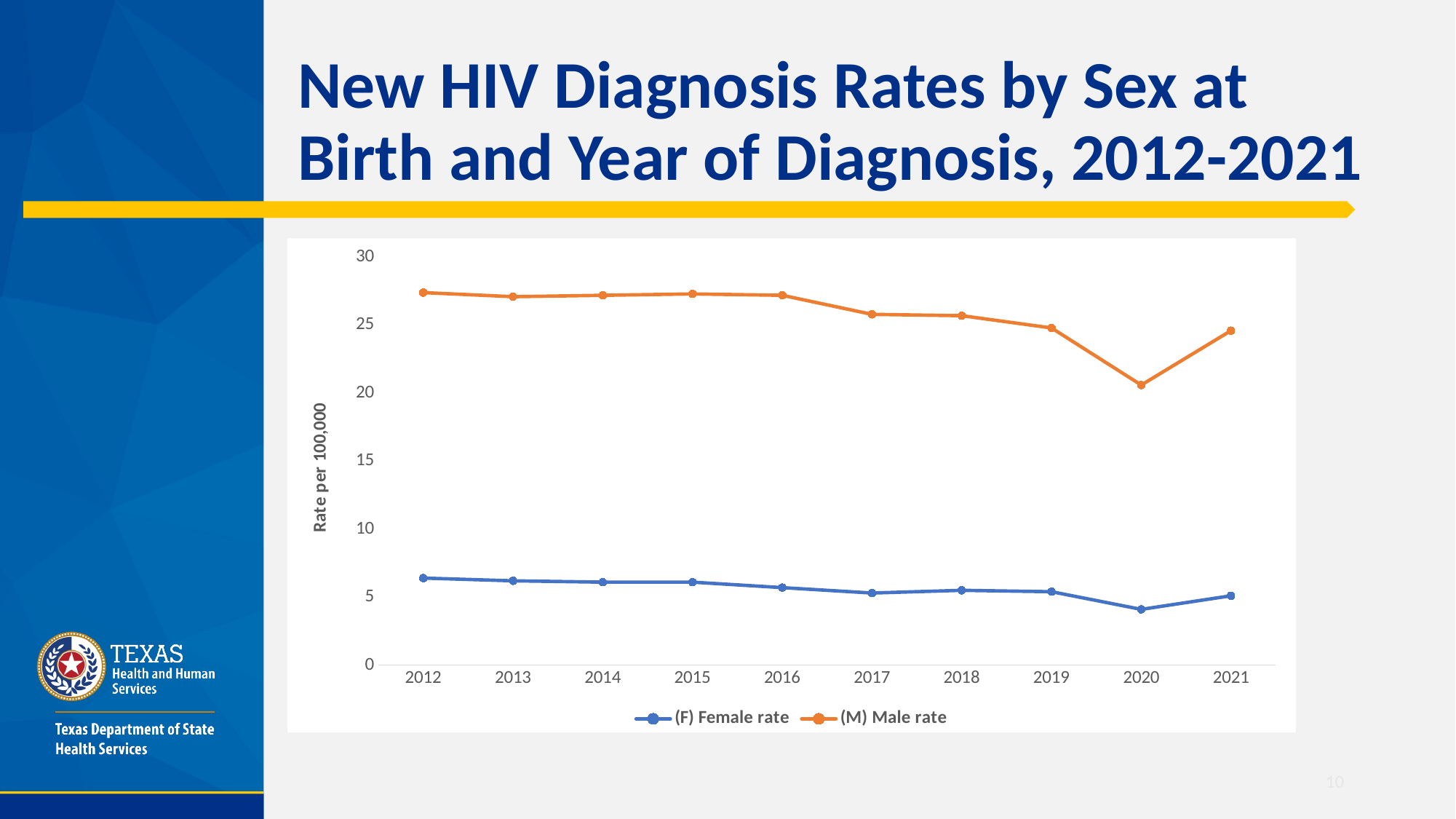
How many series does the legend list? 2 Is the (M) Male rate for 2020 greater or less than 25? less Is the (F) Female rate for 2015 greater or less than 5? greater In which year is the (M) Male rate lowest? 2020 Is the (F) Female rate for 2020 greater or less than 5? less Does the (M) Male rate rise or fall from 2016 to 2020? Fall In 2021, which is larger, the (M) Male rate or the (F) Female rate? (M) Male rate What kind of chart is shown on the slide? Line chart What is the label on the vertical axis? Rate per 100,000 In which year is the (F) Female rate lowest? 2020 How many years are plotted along the x axis? 10